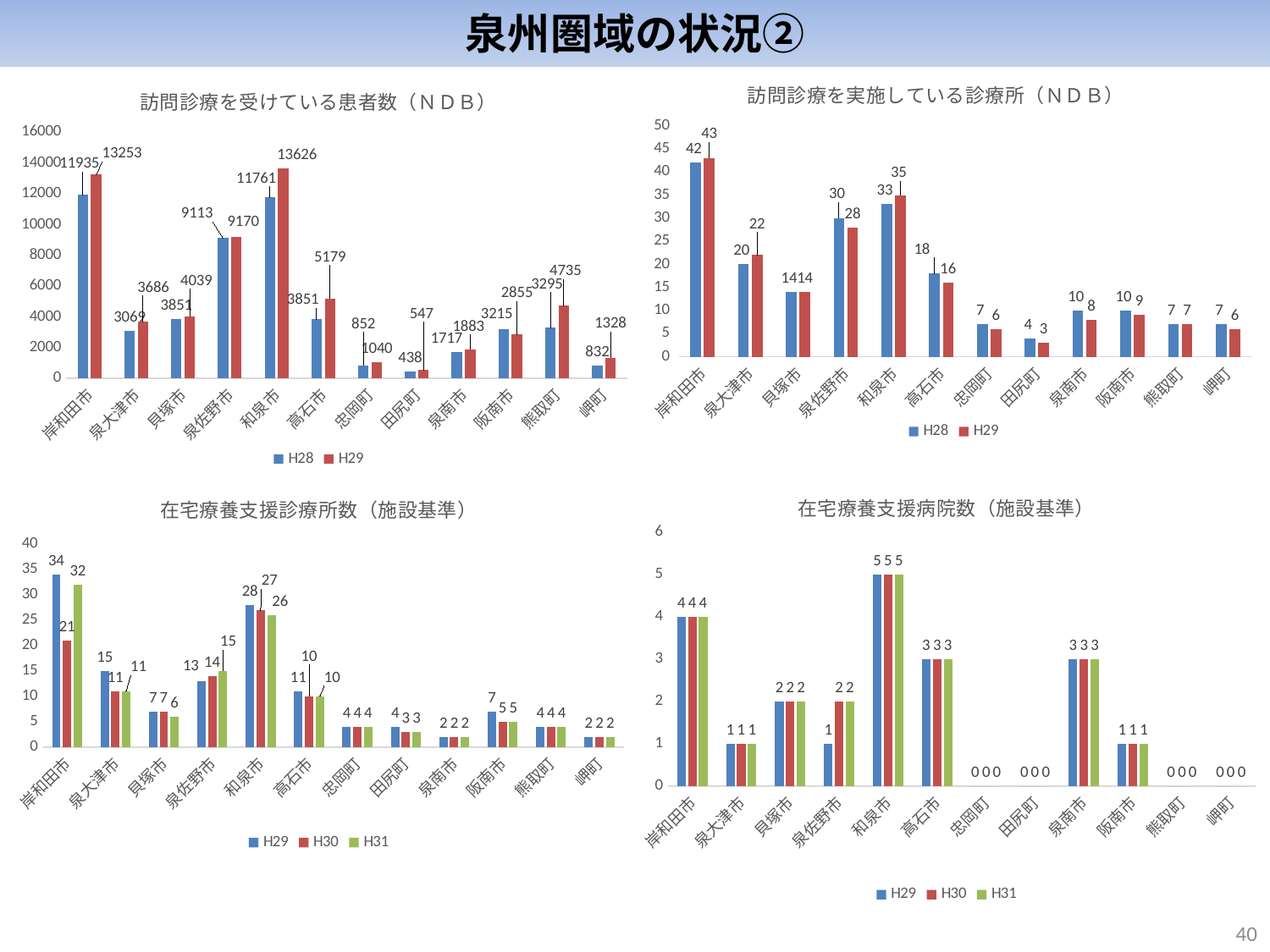
In the chart titled 訪問診療を実施している診療所（ＮＤＢ）, how many series does the legend list? 2 In the chart titled 訪問診療を受けている患者数（ＮＤＢ）, which category has the highest H28 value? 岸和田市 In the chart titled 訪問診療を受けている患者数（ＮＤＢ）, which is larger for 阪南市, the H28 value or the H29 value? H28 In the chart titled 訪問診療を実施している診療所（ＮＤＢ）, which category has the lowest H29 value? 田尻町 In the chart titled 訪問診療を実施している診療所（ＮＤＢ）, what is the H28 value for 泉佐野市? 30 What kind of chart is the chart titled 在宅療養支援病院数（施設基準）? bar chart In the chart titled 在宅療養支援診療所数（施設基準）, how many categories are shown on the x axis? 12 In the chart titled 在宅療養支援診療所数（施設基準）, do the values for 和泉市 rise or fall from H29 to H31? fall In the chart titled 在宅療養支援病院数（施設基準）, what is the H29 value for 泉佐野市? 1 In the chart titled 訪問診療を受けている患者数（ＮＤＢ）, what is the difference between the H29 and H28 values for 高石市? 1328 In the chart titled 訪問診療を受けている患者数（ＮＤＢ）, what is the H29 value for 和泉市? 13626 In the chart titled 在宅療養支援診療所数（施設基準）, what is the H30 value for 岸和田市? 21